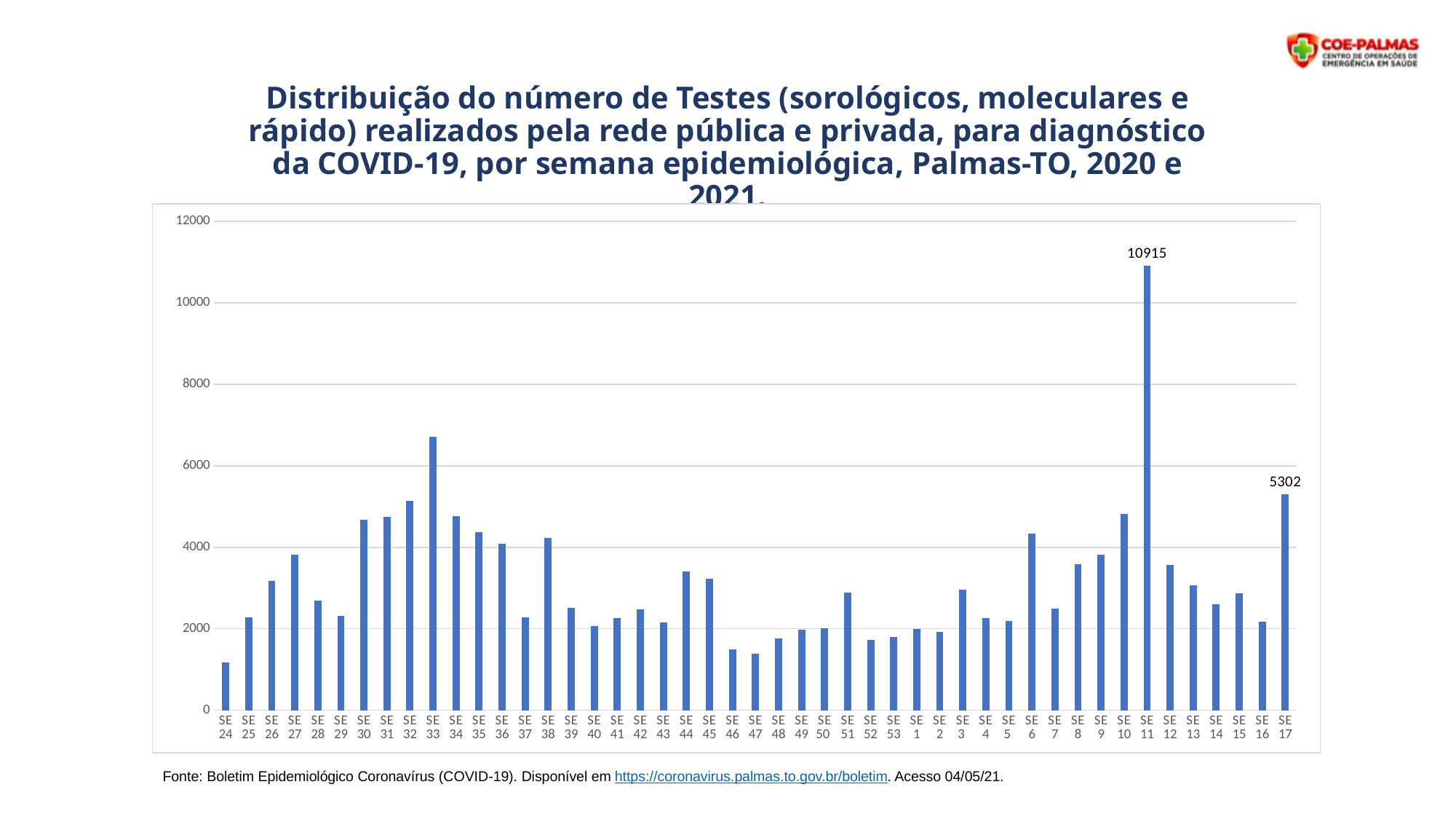
Is the value for SE 10 greater or less than 4000? greater What is the difference between the values for SE 11 and SE 17? 5613 Which epidemiological week has the highest number of tests? SE 11 What is the number of tests for SE 17? 5302 What kind of chart is shown on the slide? bar chart Which is larger, the value for SE 33 or the value for SE 32? SE 33 What is the number of tests for SE 11? 10915 Do the values rise or fall from SE 33 to SE 37? fall Is the value for SE 33 greater or less than 6000? greater Which is larger, the value for SE 3 or the value for SE 2? SE 3 How many epidemiological weeks (bars) are shown on the chart? 47 Is the value for SE 24 greater or less than 2000? less